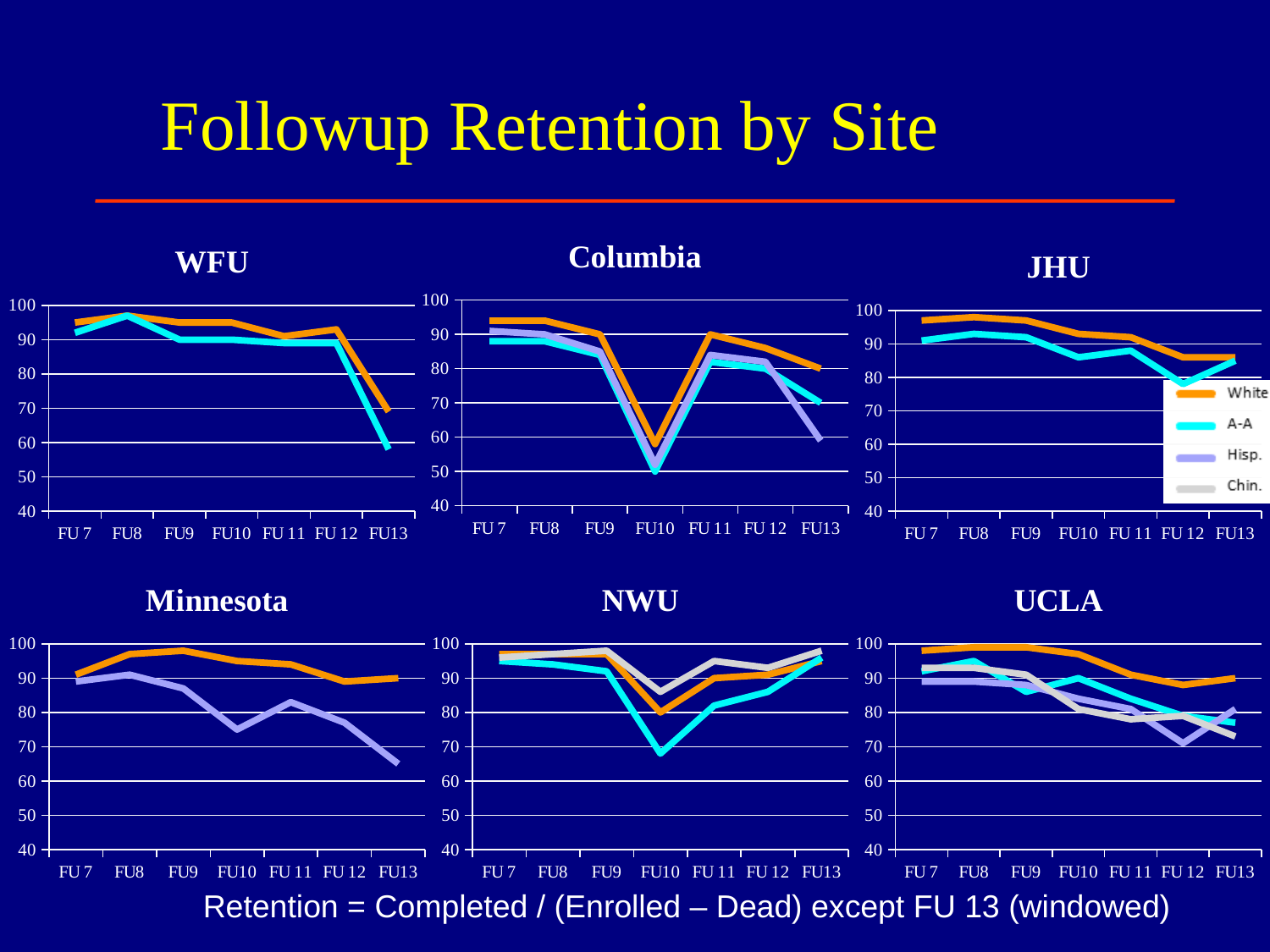
What kind of chart is the WFU chart? line chart In the Columbia chart, at which follow-up is the White series lowest? FU10 In the Columbia chart, which series has the higher value at FU13, White or Hisp.? White In the JHU chart, is the White value at FU 7 greater or less than 90? greater In the Minnesota chart, is the Hisp. value at FU13 greater or less than 70? less In the WFU chart, is the A-A value at FU13 greater or less than 70? less In the Columbia chart, how many follow-up points are shown on the x axis? 7 In the Minnesota chart, does the Hisp. series rise or fall overall from FU 7 to FU13? fall In the Minnesota chart, which series has the higher value at FU13, White or Hisp.? White How many series does the legend next to the JHU chart list? 4